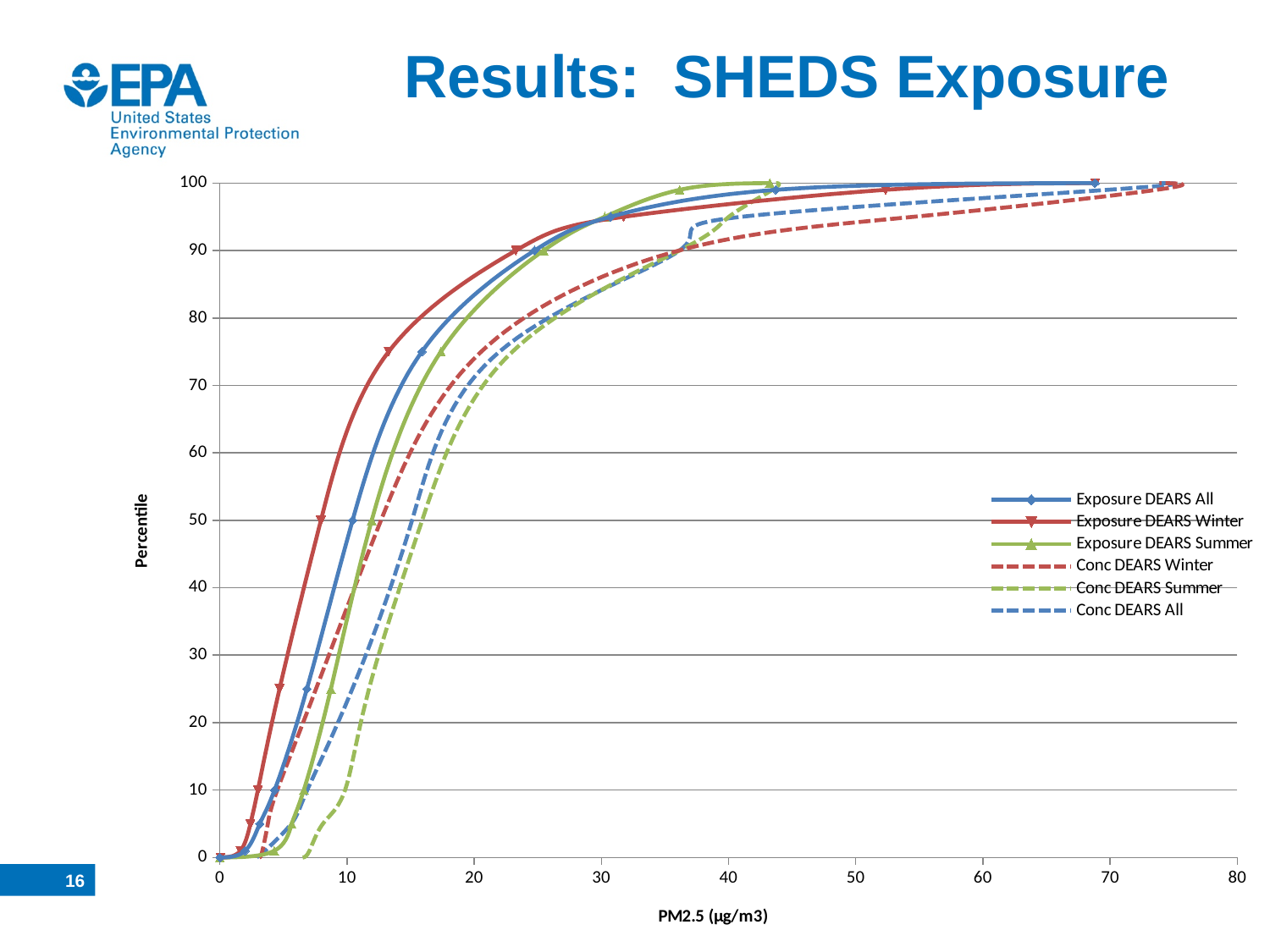
At the 50th percentile, which series has the higher PM2.5 value: Conc DEARS Summer or Exposure DEARS Winter? Conc DEARS Summer At the 50th percentile, is the PM2.5 value for Exposure DEARS Summer greater or less than 10? greater At the 75th percentile, is the PM2.5 value for Exposure DEARS Winter greater or less than 20? less At the 25th percentile, is the PM2.5 value for Conc DEARS Summer greater or less than 10? greater What is the title of the x axis? PM2.5 (µg/m3) Do the percentile values rise or fall as PM2.5 increases along the x axis? rise What is the title of the y axis? Percentile How many series does the legend list? 6 What kind of chart is shown on the slide? line chart At the 50th percentile, which series has the lower PM2.5 value: Exposure DEARS Winter or Exposure DEARS Summer? Exposure DEARS Winter